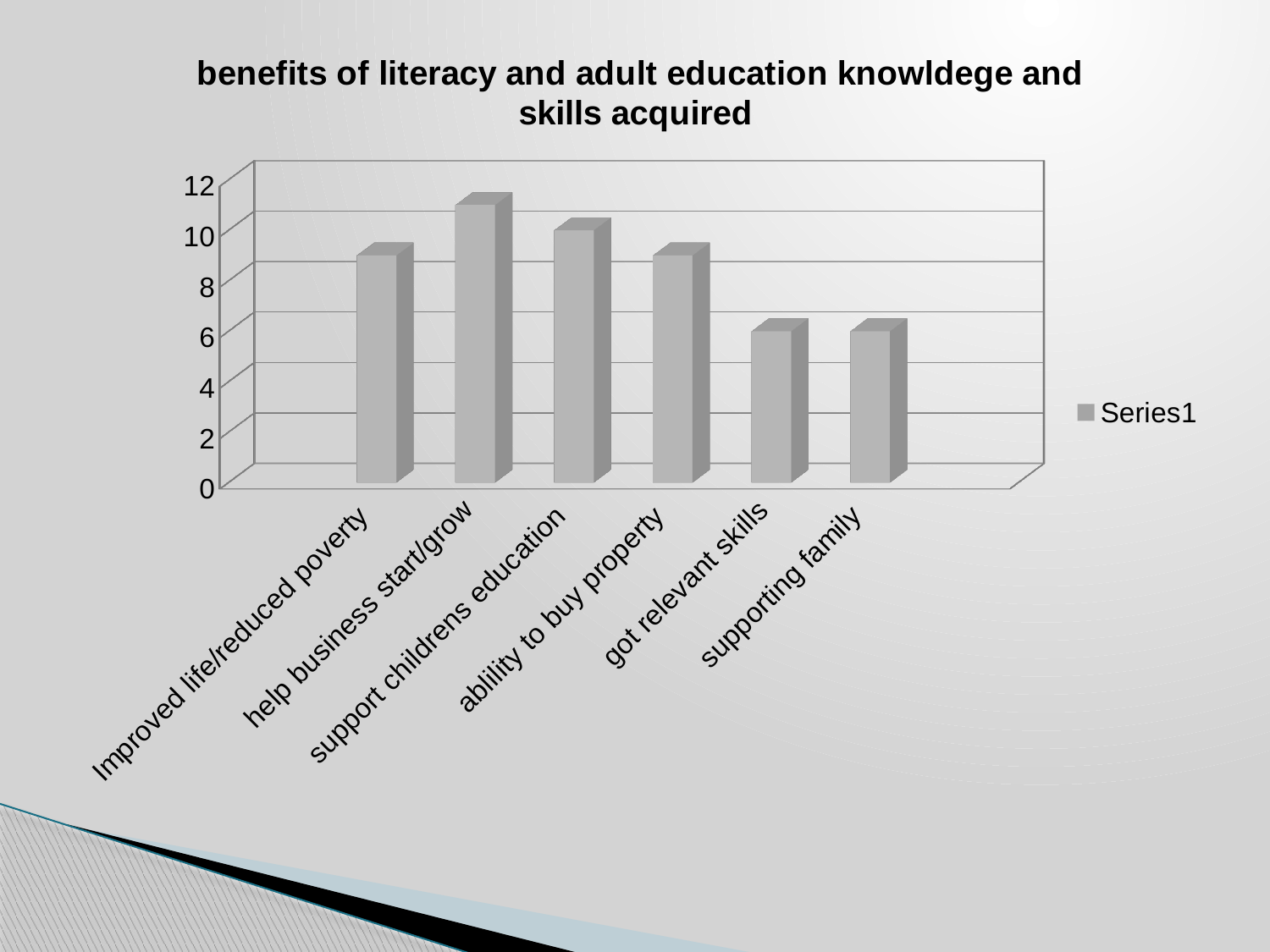
Is the value for got relevant skills greater or less than 8? less Is the value for support childrens education greater or less than 6? greater Is the value for Improved life/reduced poverty greater or less than 8? greater What is the name of the series shown in the legend? Series1 Which is larger, the value for help business start/grow or the value for got relevant skills? help business start/grow What kind of chart is shown on the slide? bar chart How many series does the legend list? 1 Which category has the highest bar? help business start/grow How many categories are plotted on the x axis? 6 Which is larger, the value for support childrens education or the value for supporting family? support childrens education